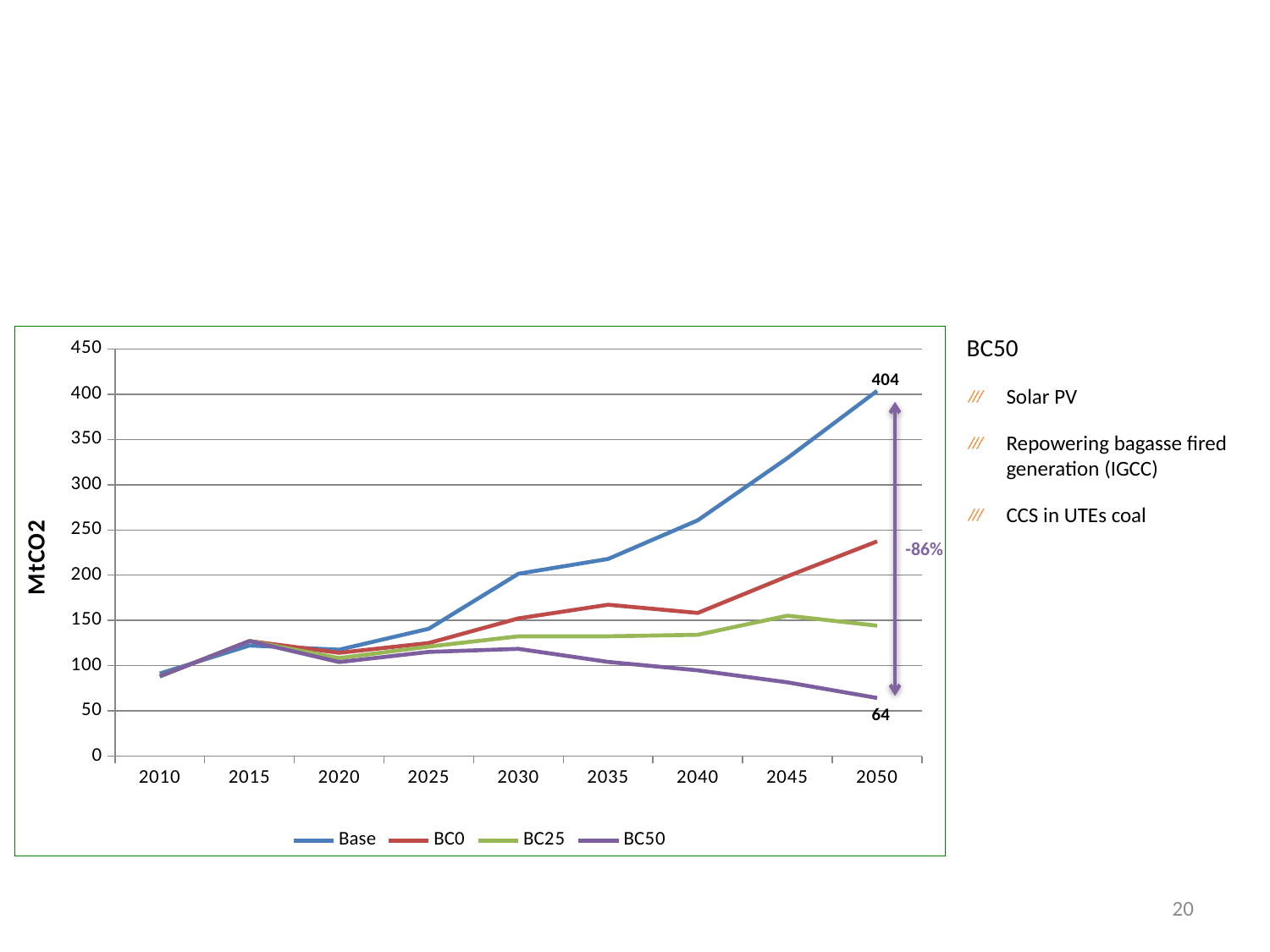
How many years are shown on the x axis? 9 Which is larger in 2050, BC0 or BC25? BC0 Is the value for BC0 in 2050 greater or less than 200? greater How many series does the legend list? 4 Does the Base series rise or fall between 2030 and 2050? rise Which series has the lowest value in 2050? BC50 What is the difference between the Base and BC50 values in 2050? 340 What is the value of the BC50 series in 2050? 64 Which series has the highest value in 2050? Base What is the label on the y axis? MtCO2 What kind of chart is shown on the slide? line chart What is the value of the Base series in 2050? 404